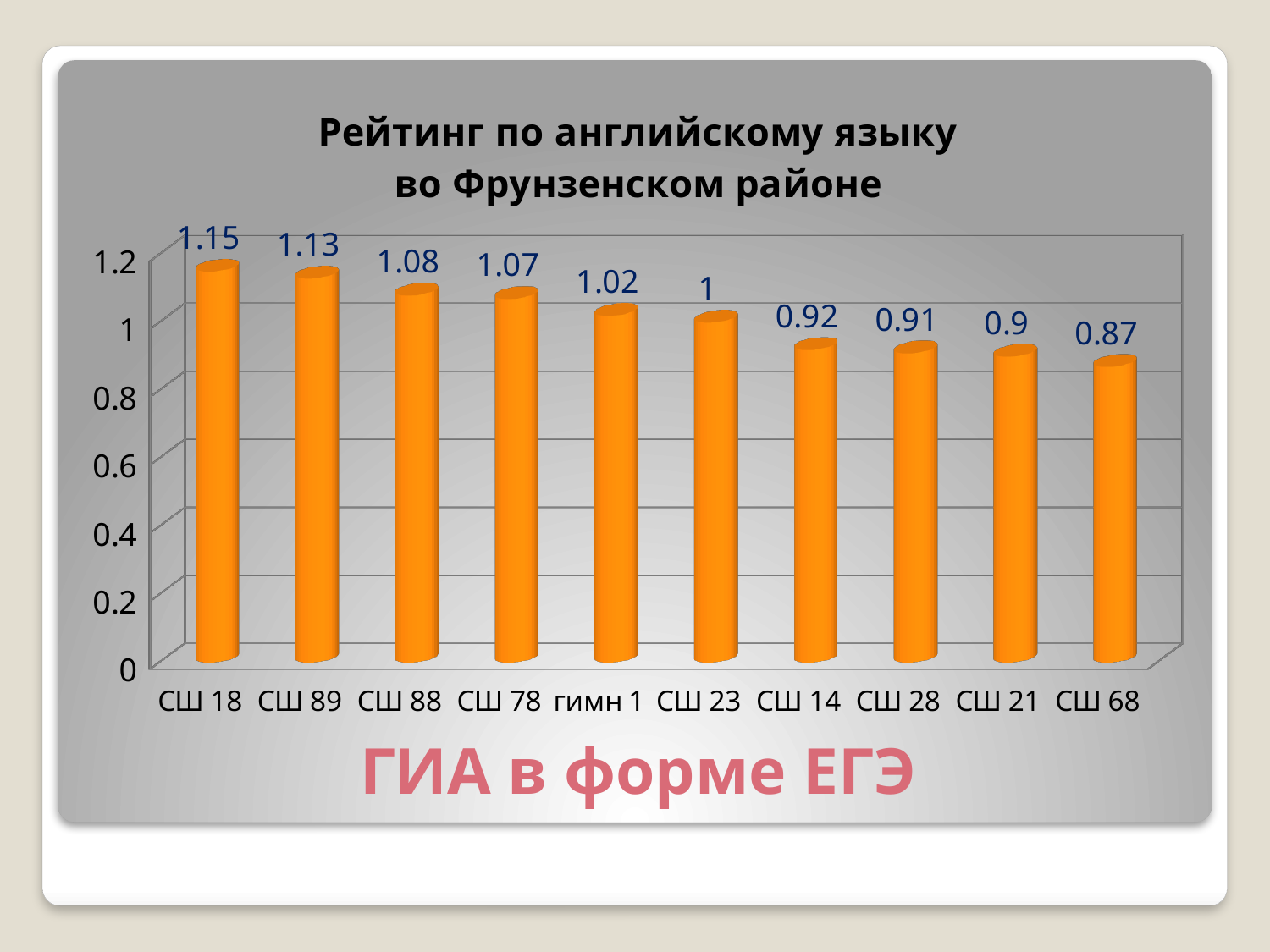
What is the value for СШ 18? 1.15 Do the values rise or fall from left to right along the x axis? fall What is the value for СШ 68? 0.87 What is the value for СШ 23? 1 What is the difference between the values for СШ 18 and СШ 68? 0.28 How many categories are shown on the x axis? 10 Which category has the highest value? СШ 18 What is the value for гимн 1? 1.02 What kind of chart is shown on the slide? bar chart What is the title of the chart? Рейтинг по английскому языку во Фрунзенском районе Which is larger, the value for СШ 89 or the value for СШ 14? СШ 89 Which category has the lowest value? СШ 68